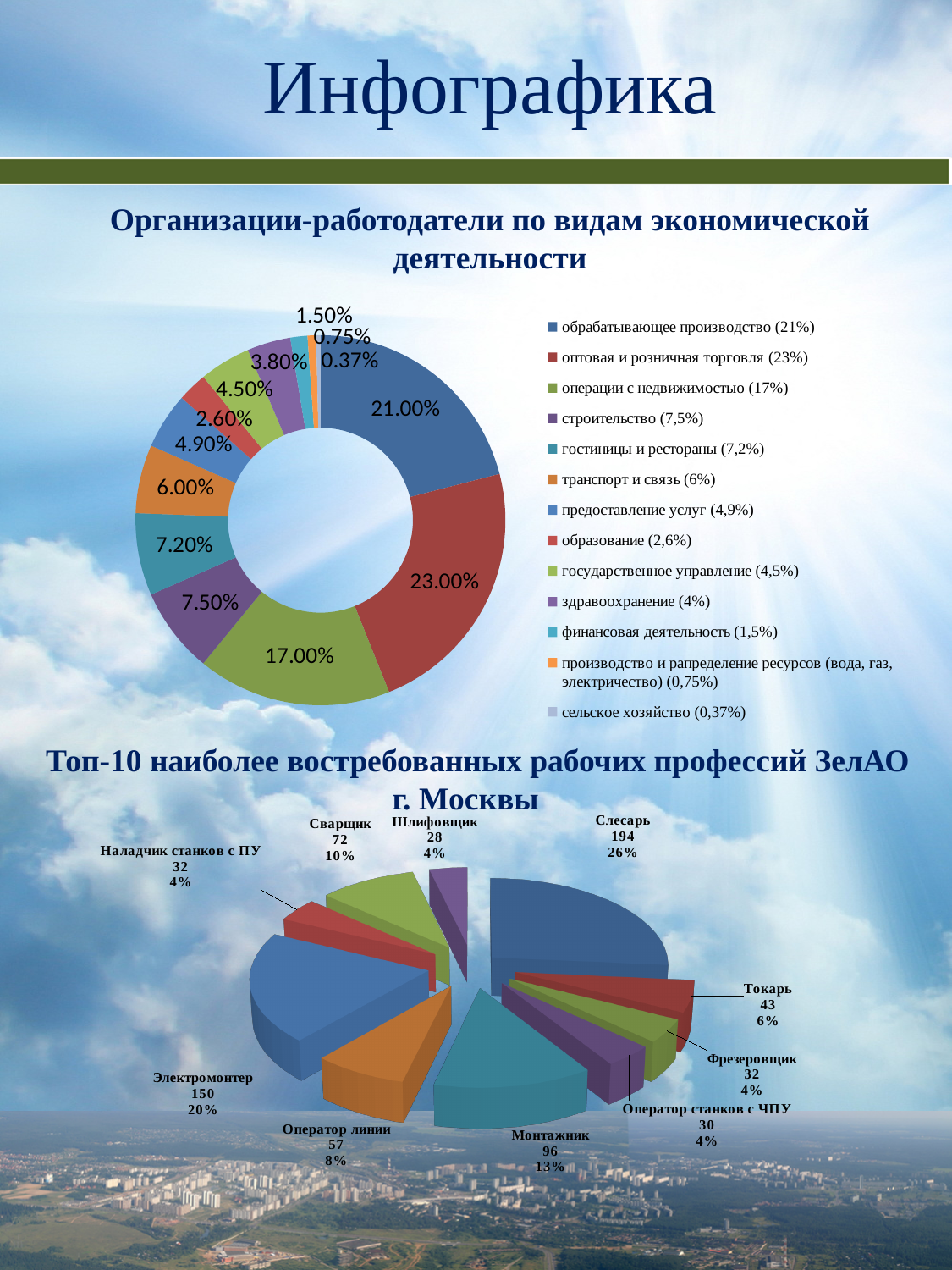
In the chart 'Топ-10 наиболее востребованных рабочих профессий ЗелАО г. Москвы', which profession has the highest value? Слесарь In the chart 'Организации-работодатели по видам экономической деятельности', which category has the largest share? оптовая и розничная торговля In the chart 'Организации-работодатели по видам экономической деятельности', which category has the smallest share? сельское хозяйство In the chart 'Топ-10 наиболее востребованных рабочих профессий ЗелАО г. Москвы', which profession has the lowest value? Шлифовщик In the chart 'Организации-работодатели по видам экономической деятельности', what share is labelled for оптовая и розничная торговля? 23.00% In the chart 'Топ-10 наиболее востребованных рабочих профессий ЗелАО г. Москвы', what is the value for Электромонтер? 150 In the chart 'Организации-работодатели по видам экономической деятельности', how many categories does the legend list? 13 What kind of chart is 'Организации-работодатели по видам экономической деятельности'? doughnut chart In the chart 'Топ-10 наиболее востребованных рабочих профессий ЗелАО г. Москвы', what percentage share is shown for Монтажник? 13% In the chart 'Топ-10 наиболее востребованных рабочих профессий ЗелАО г. Москвы', which is larger, the value for Сварщик or the value for Оператор линии? Сварщик In the chart 'Топ-10 наиболее востребованных рабочих профессий ЗелАО г. Москвы', what is the difference between the values for Слесарь and Электромонтер? 44 In the chart 'Организации-работодатели по видам экономической деятельности', what share is labelled for транспорт и связь? 6.00%